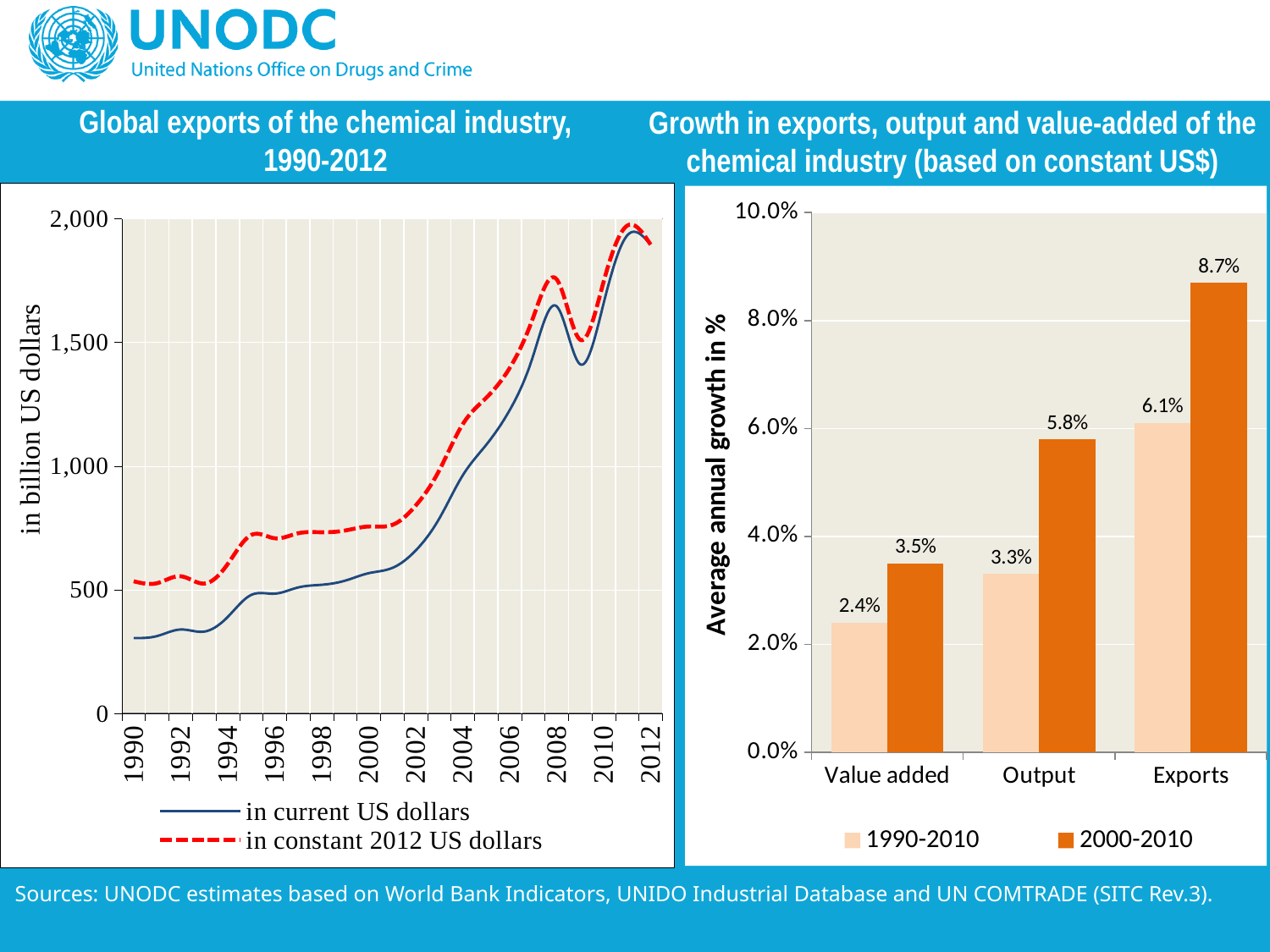
In the 'Growth in exports, output and value-added of the chemical industry' chart, what is the 1990-2010 value for Value added? 2.4% In the 'Growth in exports, output and value-added of the chemical industry' chart, what is the 2000-2010 value for Output? 5.8% In the 'Growth in exports, output and value-added of the chemical industry' chart, what is the difference between the 2000-2010 and 1990-2010 values for Exports? 2.6% In the 'Growth in exports, output and value-added of the chemical industry' chart, which is larger: the 1990-2010 value for Output or the 2000-2010 value for Value added? 2000-2010 value for Value added In the 'Growth in exports, output and value-added of the chemical industry' chart, which category has the highest 2000-2010 value? Exports In the 'Growth in exports, output and value-added of the chemical industry' chart, what is the 2000-2010 value for Exports? 8.7% In the 'Global exports of the chemical industry, 1990-2012' chart, do the values in current US dollars generally rise or fall from 1990 to 2012? rise In the 'Growth in exports, output and value-added of the chemical industry' chart, how many series does the legend list? 2 In the 'Global exports of the chemical industry, 1990-2012' chart, is the value in constant 2012 US dollars for 2008 greater or less than 1,500? greater In the 'Growth in exports, output and value-added of the chemical industry' chart, which category has the lowest 1990-2010 value? Value added In the 'Growth in exports, output and value-added of the chemical industry' chart, how many categories are shown on the x axis? 3 What kind of chart is 'Global exports of the chemical industry, 1990-2012'? Line chart